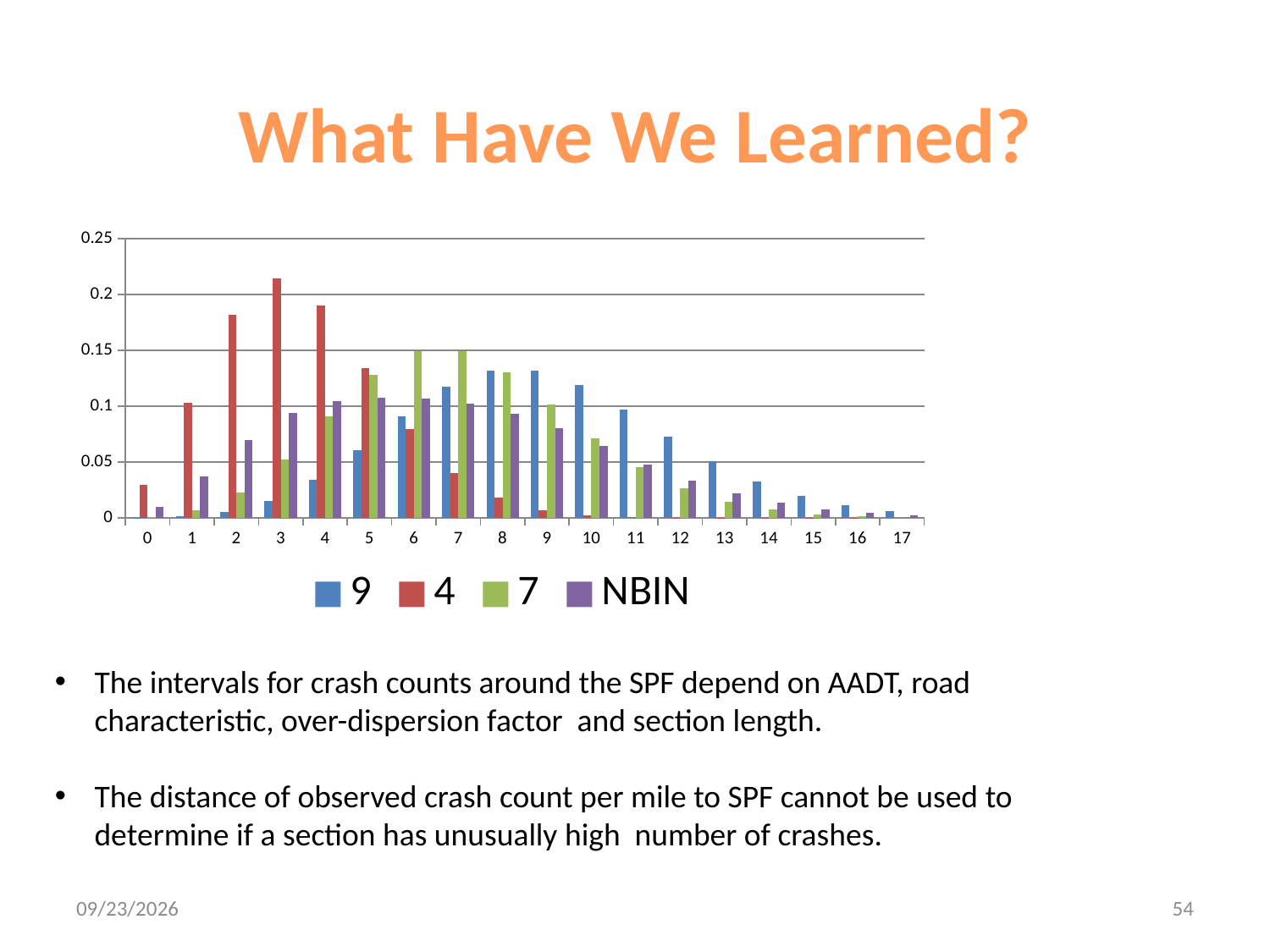
Which series has the tallest bar in the chart? 4 Do the values for series 4 rise or fall from category 4 to category 8? fall Is the value for series 7 at category 10 greater or less than 0.1? less Is the value for series 4 at category 3 greater or less than 0.2? greater For series 4, which category has the highest value? 3 How many categories are shown along the x axis? 18 Is the value for series 4 at category 2 greater or less than 0.15? greater How many series does the legend list? 4 At category 6, which series has the larger value, 7 or 4? 7 What kind of chart is shown on the slide? bar chart At category 8, which series has the larger value, 9 or 4? 9